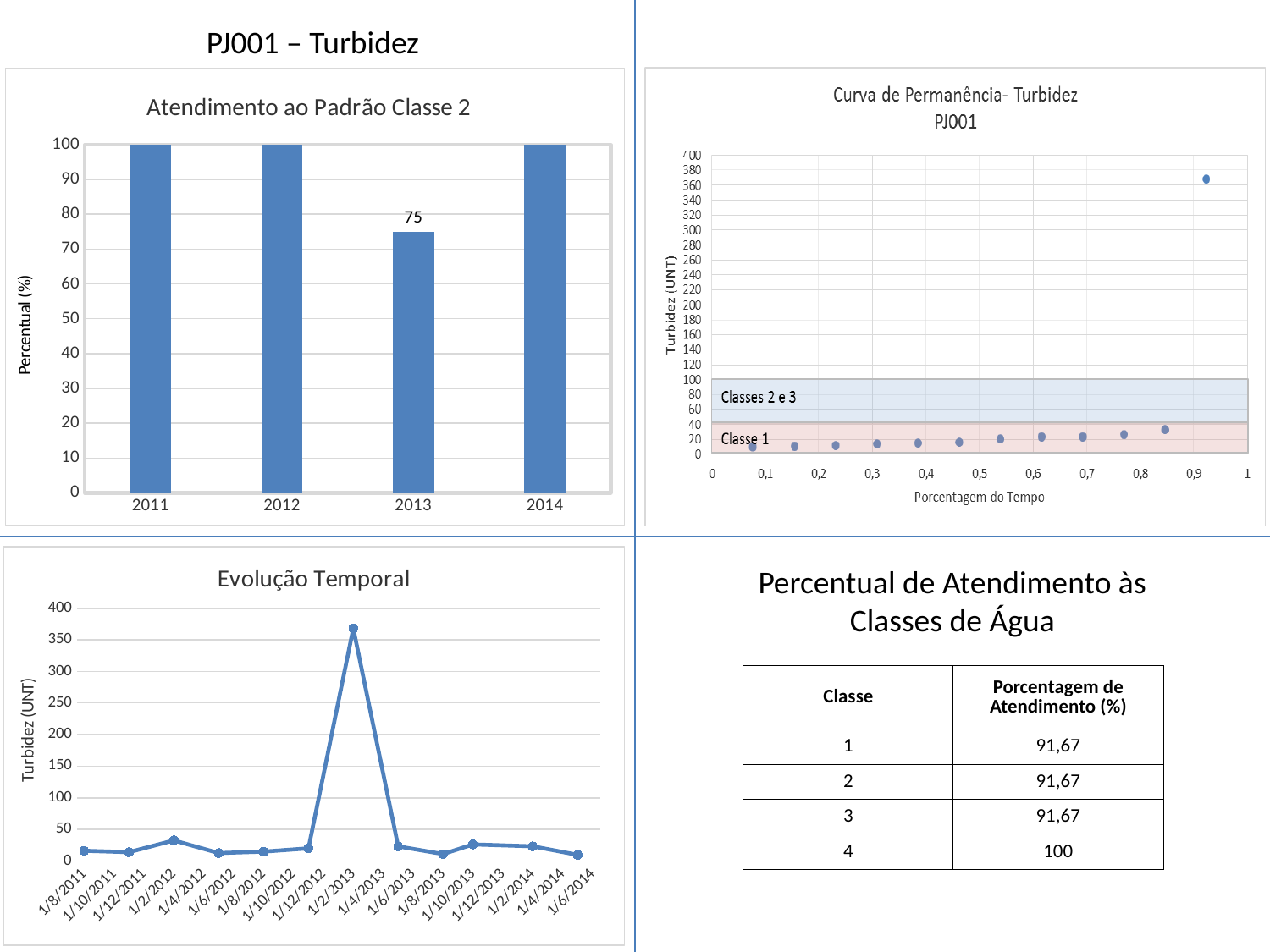
In the 'Curva de Permanência- Turbidez PJ001' chart, what is the title of the x axis? Porcentagem do Tempo In the 'Curva de Permanência- Turbidez PJ001' chart, is the highest point greater or less than 300? greater In the 'Atendimento ao Padrão Classe 2' chart, what is the value for 2011? 100 What kind of chart is 'Atendimento ao Padrão Classe 2'? bar chart In the 'Atendimento ao Padrão Classe 2' chart, which year has the lowest value? 2013 In the 'Curva de Permanência- Turbidez PJ001' chart, what label is shown in the lower shaded band? Classe 1 In the 'Atendimento ao Padrão Classe 2' chart, how many years are shown on the x axis? 4 What kind of chart is 'Evolução Temporal'? line chart In the 'Atendimento ao Padrão Classe 2' chart, what is the value for 2013? 75 In the 'Evolução Temporal' chart, is the highest point greater or less than 350? greater In the 'Atendimento ao Padrão Classe 2' chart, what is the difference between the values for 2012 and 2013? 25 In the 'Atendimento ao Padrão Classe 2' chart, is the value for 2013 greater or less than 80? less